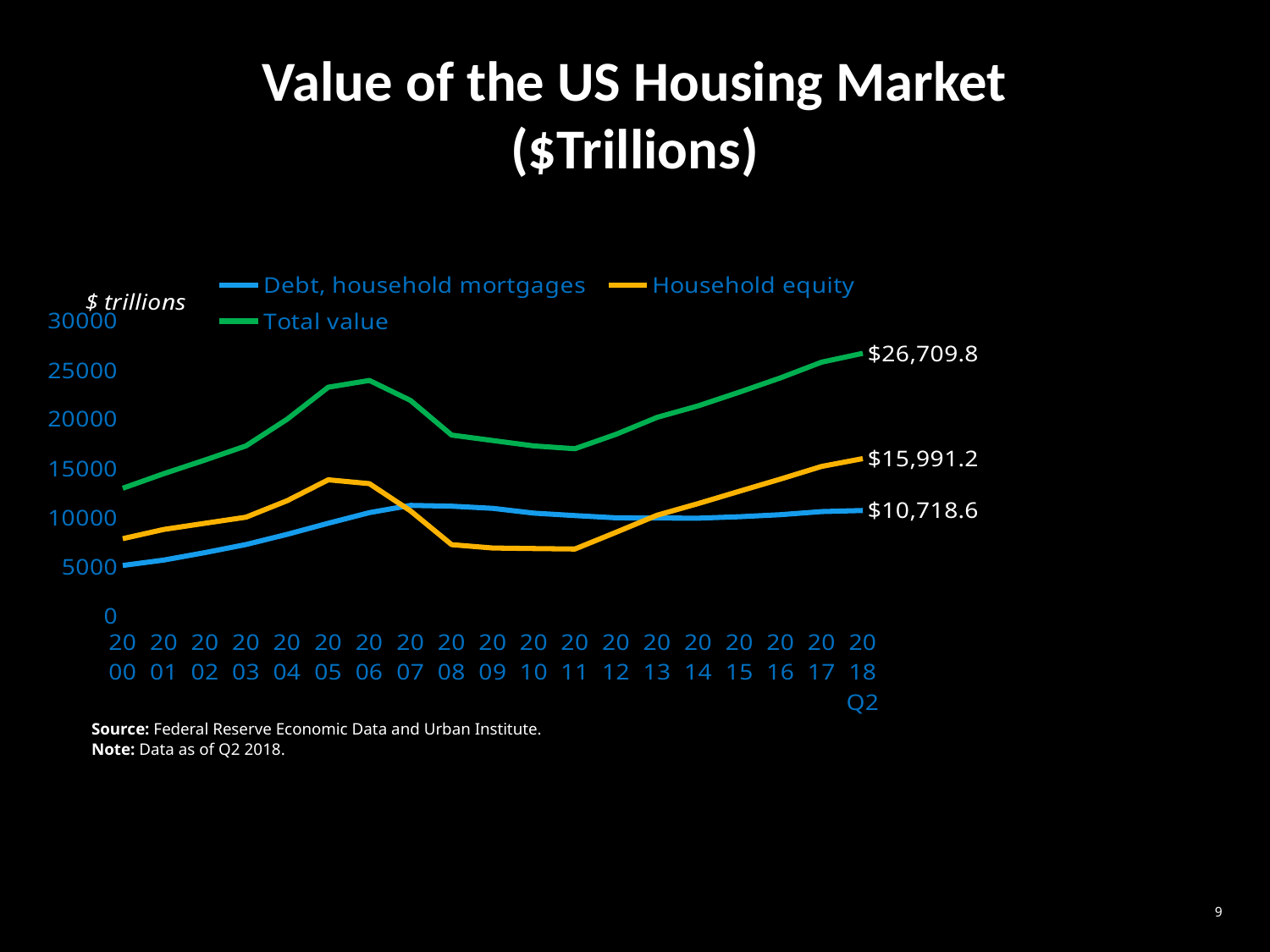
In 2018 Q2, what is the difference between Household equity and Debt, household mortgages? $5,272.6 What is the Household equity value in 2018 Q2? $15,991.2 Which series has the highest value in 2018 Q2? Total value How many time points are shown on the x axis? 19 What is the Total value in 2018 Q2? $26,709.8 Is the Household equity value in 2008 greater or less than 10000? less How many series does the legend list? 3 In 2018 Q2, which is larger: Household equity or Debt, household mortgages? Household equity What type of chart is shown on the slide? Line chart Is the Total value in 2006 greater or less than 20000? greater What is the value of Debt, household mortgages in 2018 Q2? $10,718.6 Does the Total value rise or fall from 2011 to 2018 Q2? Rises